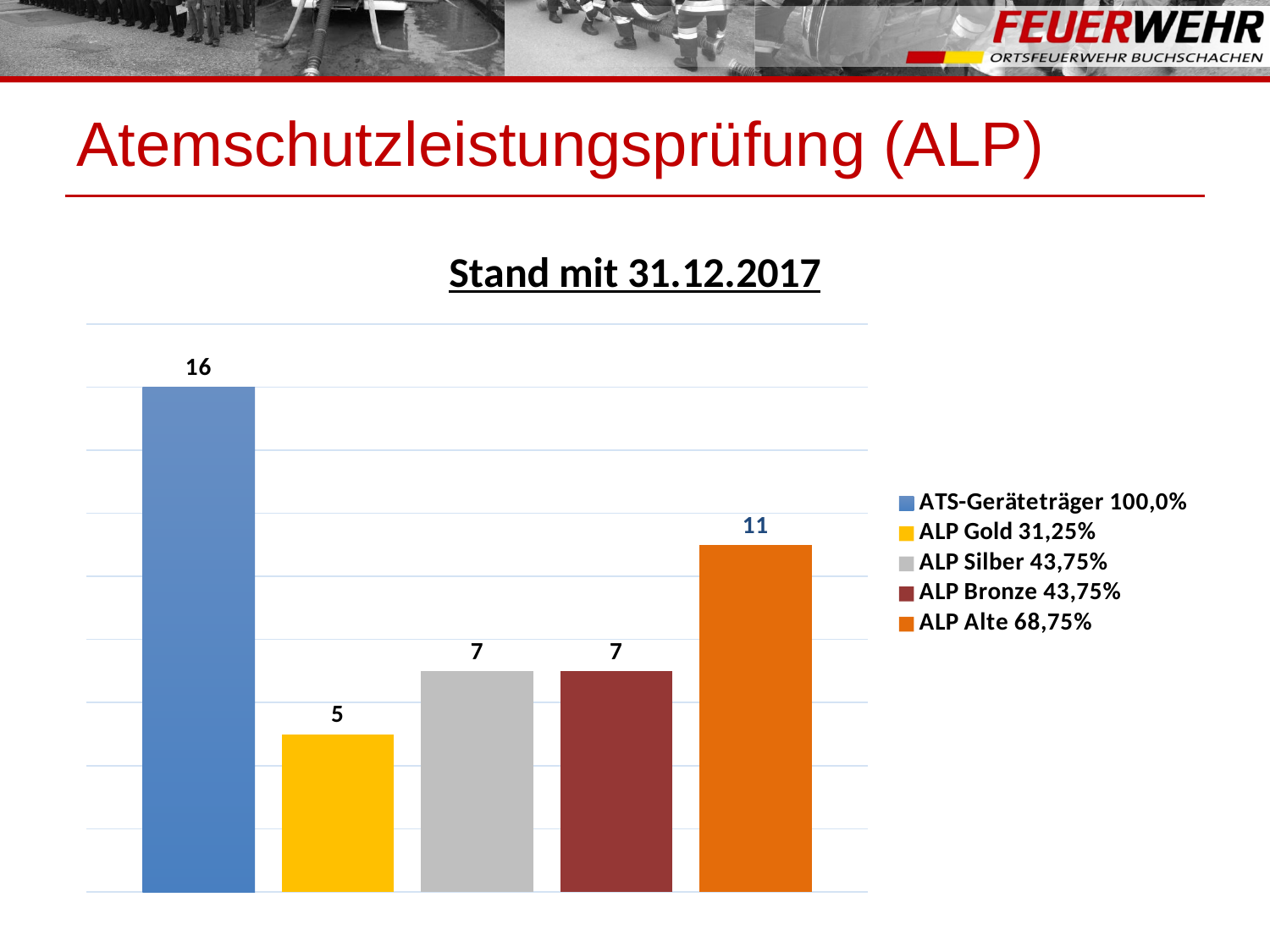
What is the difference between the values for ALP Bronze and ALP Gold? 2 Which category has the highest value? ATS-Geräteträger What kind of chart is shown on the slide? Bar chart What percentage is shown in the legend for ALP Alte? 68,75% What is the value for ALP Gold? 5 Which is larger, the value for ALP Alte or the value for ALP Silber? ALP Alte What is the difference between the values for ATS-Geräteträger and ALP Alte? 5 What is the value for ALP Alte? 11 Which category has the lowest value? ALP Gold What is the value for ATS-Geräteträger? 16 How many bars are shown in the chart? 5 What is the value for ALP Silber? 7